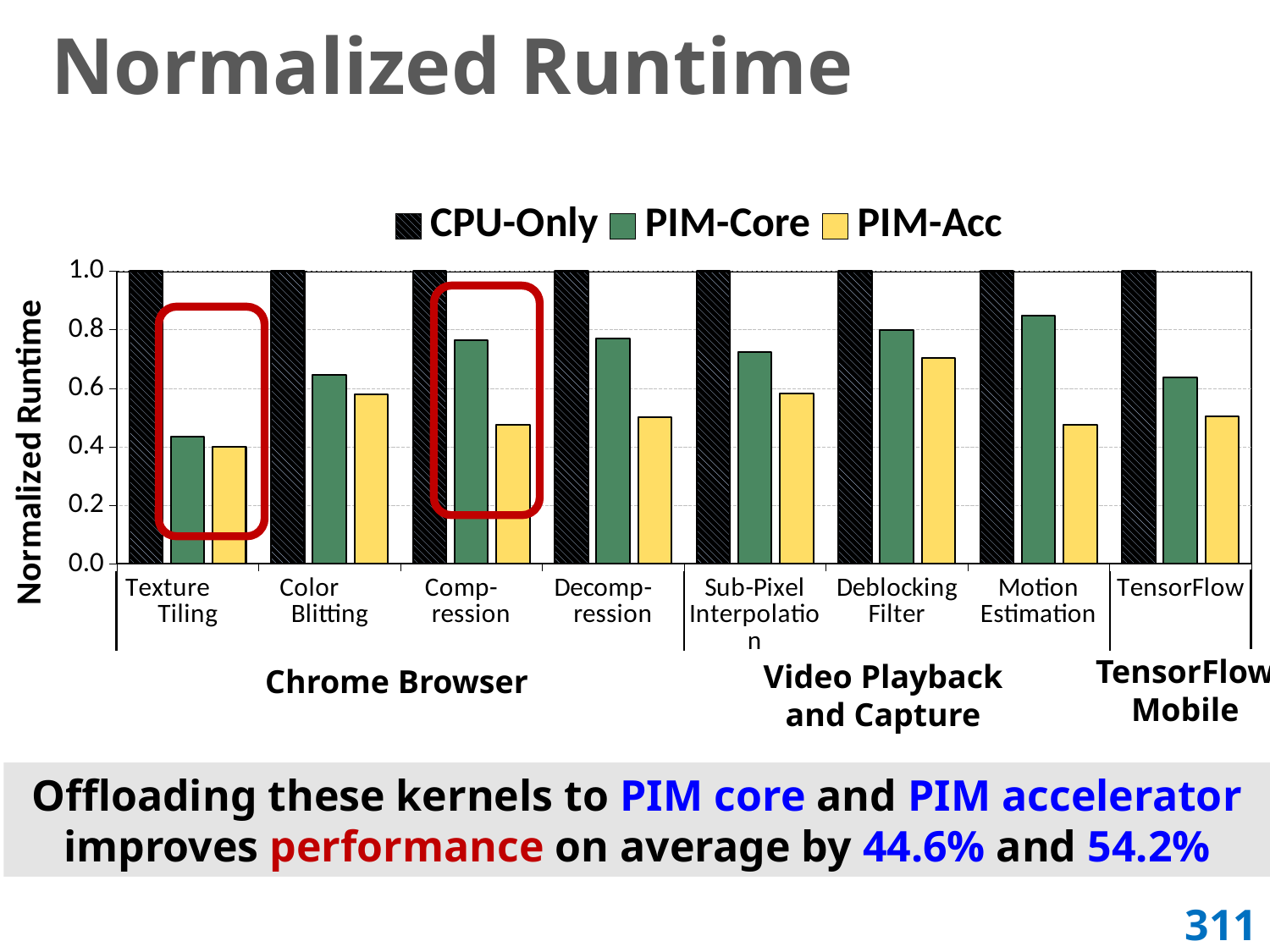
How many kernel categories are plotted along the x axis? 8 Which category has the lowest PIM-Acc normalized runtime? Texture Tiling Which is larger: the PIM-Core value for Color Blitting or the PIM-Core value for Compression? Compression Is the PIM-Acc value for Compression greater or less than 0.6? less Is the PIM-Core value for Texture Tiling greater or less than 0.6? less Is the PIM-Core value for Motion Estimation greater or less than 0.8? greater What is the label on the y axis of the chart? Normalized Runtime For Motion Estimation, which is larger: the PIM-Core value or the PIM-Acc value? PIM-Core What is the CPU-Only normalized runtime for Texture Tiling? 1.0 What kind of chart is shown on the slide? bar chart How many series does the legend list? 3